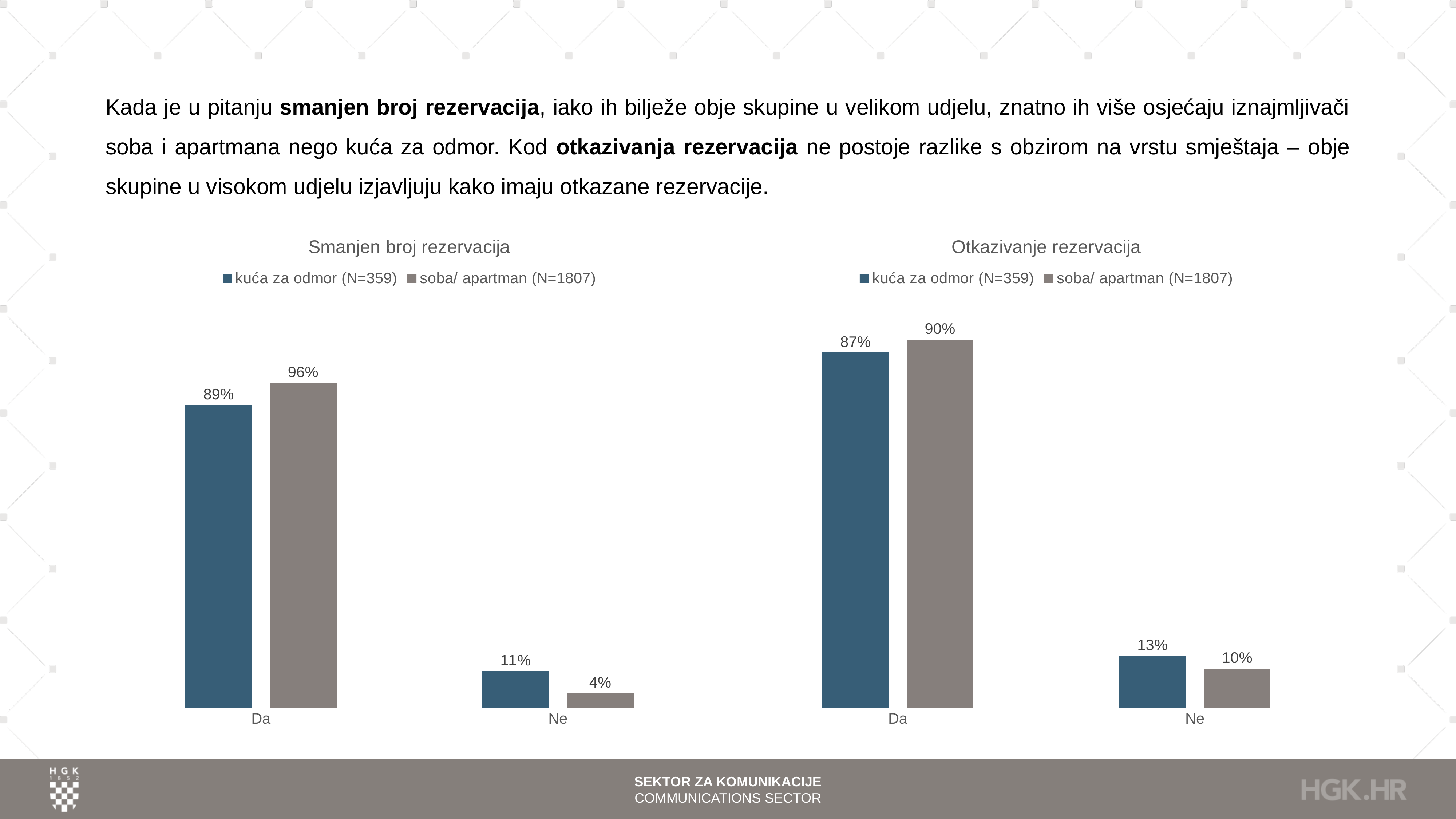
In the 'Smanjen broj rezervacija' chart, which series has the larger value for 'Ne'? kuća za odmor (N=359) In the 'Smanjen broj rezervacija' chart, what is the value for 'kuća za odmor (N=359)' for 'Ne'? 11% In the 'Otkazivanje rezervacija' chart, what is the difference between the 'kuća za odmor (N=359)' and 'soba/ apartman (N=1807)' values for 'Ne'? 3% In the 'Smanjen broj rezervacija' chart, what is the difference between the 'soba/ apartman (N=1807)' and 'kuća za odmor (N=359)' values for 'Da'? 7% In the 'Otkazivanje rezervacija' chart, what is the value for 'soba/ apartman (N=1807)' for 'Ne'? 10% What kind of chart is the 'Otkazivanje rezervacija' chart? Bar chart In the 'Smanjen broj rezervacija' chart, which bar has the lowest value? soba/ apartman (N=1807) for Ne (4%) In the 'Otkazivanje rezervacija' chart, what is the value for 'kuća za odmor (N=359)' for 'Da'? 87% In the 'Smanjen broj rezervacija' chart, what is the value for 'soba/ apartman (N=1807)' for 'Da'? 96% In the 'Otkazivanje rezervacija' chart, which series has the larger value for 'Da'? soba/ apartman (N=1807) How many series does the legend of the 'Otkazivanje rezervacija' chart list? 2 How many categories are shown on the x axis of the 'Smanjen broj rezervacija' chart? 2